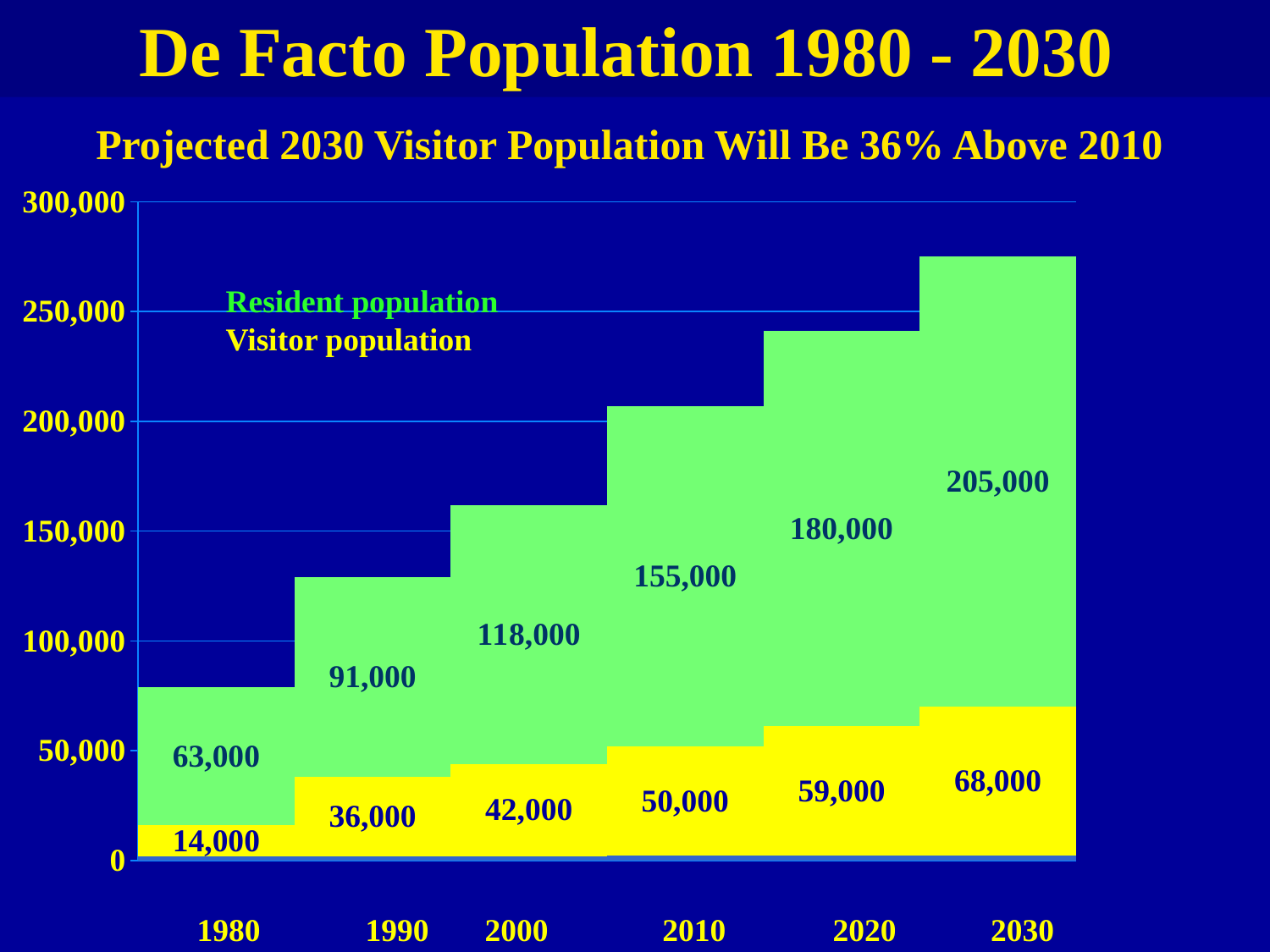
Which is larger, the resident population in 2000 or the resident population in 2010? 2010 What is the visitor population shown for 2010? 50,000 How many series does the legend list? 2 What is the total de facto population (resident plus visitor) for 2030? 273,000 What is the difference between the resident population in 2020 and in 1990? 89,000 What is the difference between the visitor population in 2030 and in 2010? 18,000 How many years are shown on the x axis? 6 What is the visitor population shown for 1980? 14,000 Which year has the lowest resident population? 1980 Which year has the highest visitor population? 2030 Does the visitor population rise or fall from 1980 to 2030? rise What is the resident population shown for 2030? 205,000